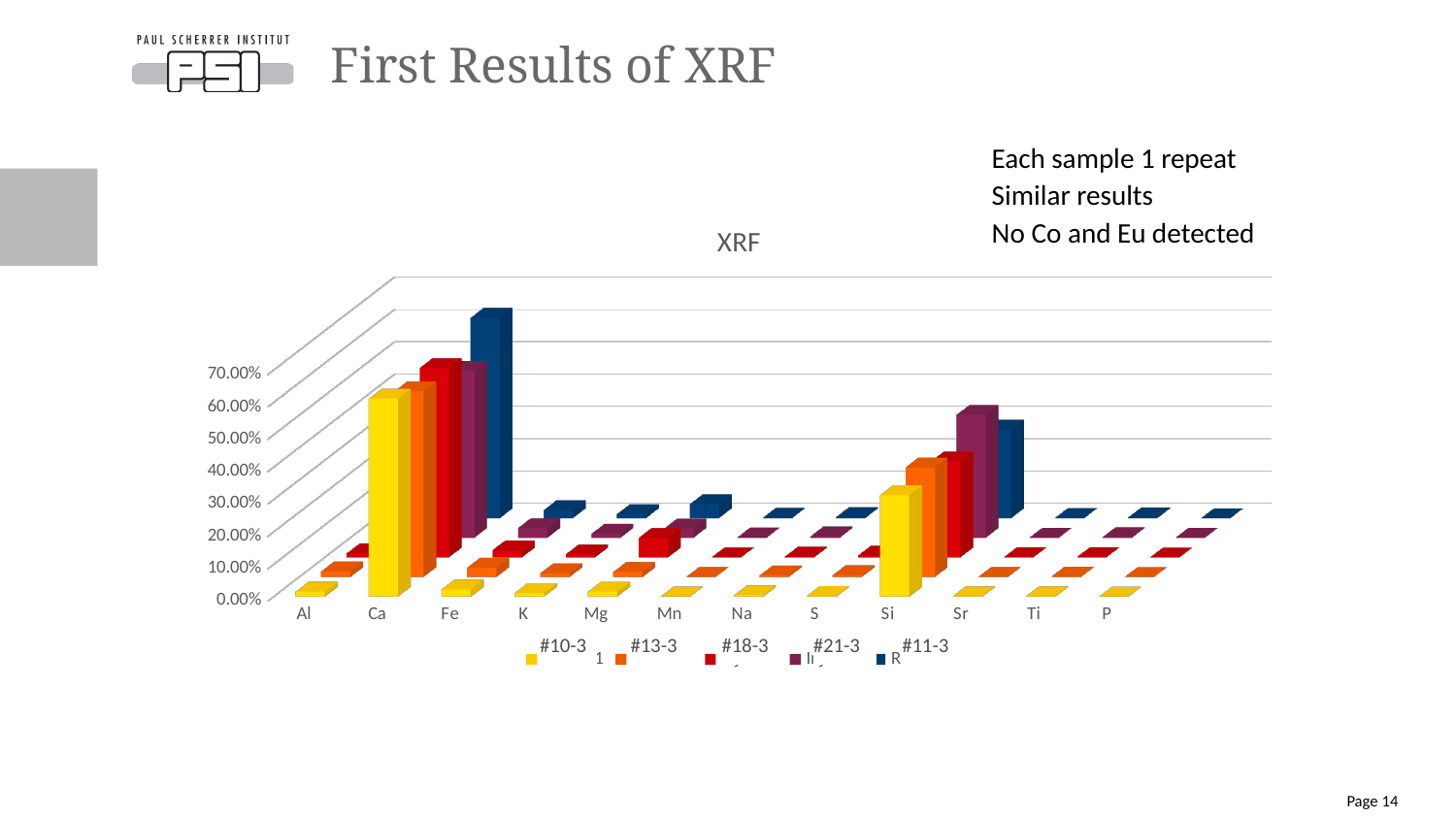
Is the value for Ca in the #10-3 series greater or less than 30.00%? greater How many series does the chart legend list? 5 Is the value for Si in the #10-3 series greater or less than 10.00%? greater Which element category has the tallest bars in the chart? Ca For the #10-3 series, is the value for Ca or Si larger? Ca What is the title of the chart? XRF Which series is shown in yellow in the chart legend? #10-3 How many element categories are shown on the x axis of the chart? 12 For the #10-3 series, which element has the highest value? Ca Is the value for Al in the #10-3 series greater or less than 10.00%? less For the #10-3 series, is the value for Si or Ti larger? Si What kind of chart is shown on the slide? bar chart